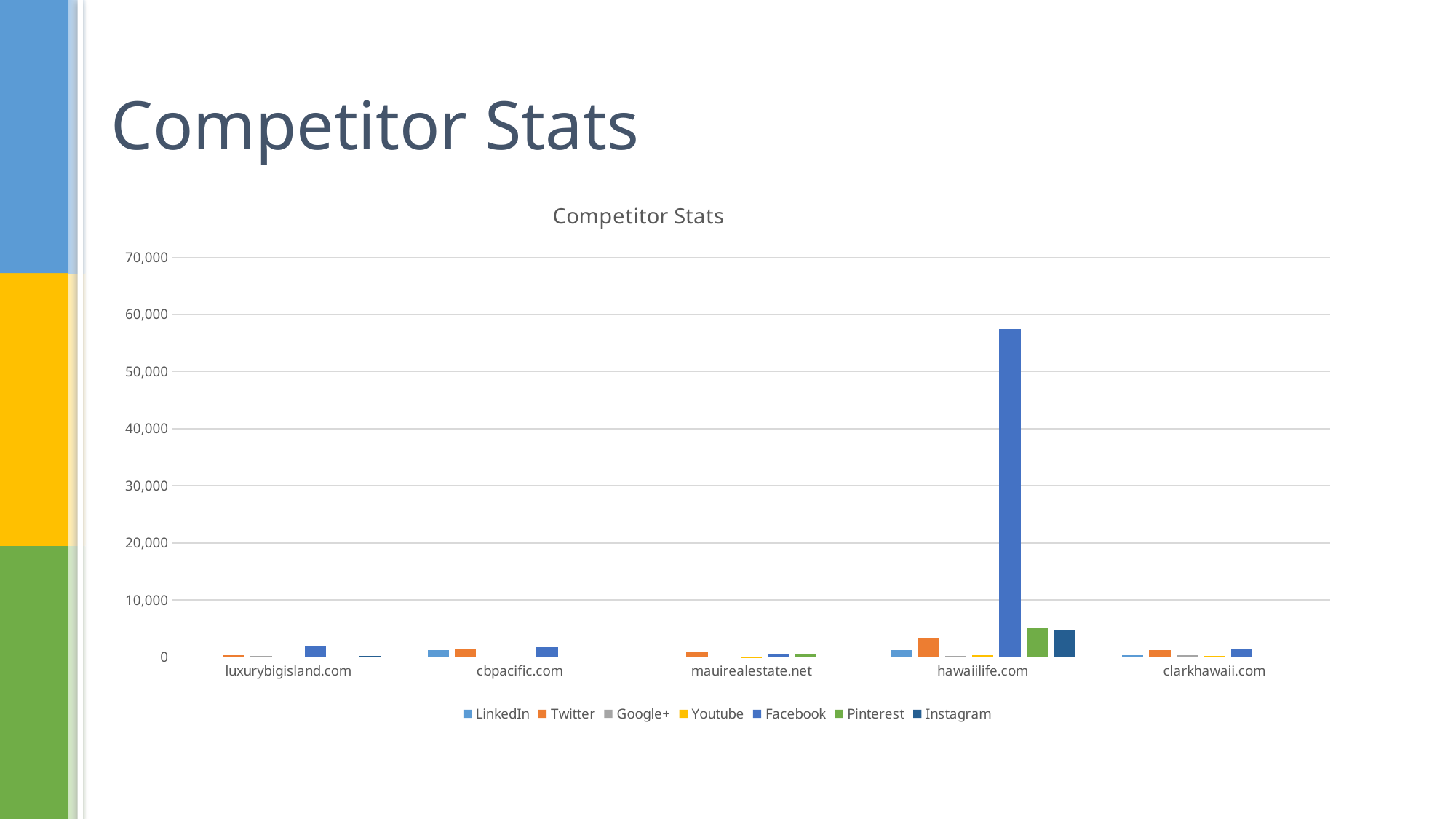
Which competitor has the tallest bar in the chart? hawaiilife.com Which is larger for hawaiilife.com, the Twitter value or the LinkedIn value? Twitter Which is larger, the Facebook value for hawaiilife.com or the Facebook value for cbpacific.com? hawaiilife.com Which series has the highest value for hawaiilife.com? Facebook What is the title of the chart? Competitor Stats How many competitor websites are shown on the x axis? 5 What kind of chart is shown on the slide? bar chart Is the Facebook value for hawaiilife.com greater or less than 50,000? greater How many series does the legend list? 7 Is the Facebook value for hawaiilife.com greater or less than 60,000? less Which series is shown in orange in the legend? Twitter Is the Pinterest value for hawaiilife.com greater or less than 10,000? less